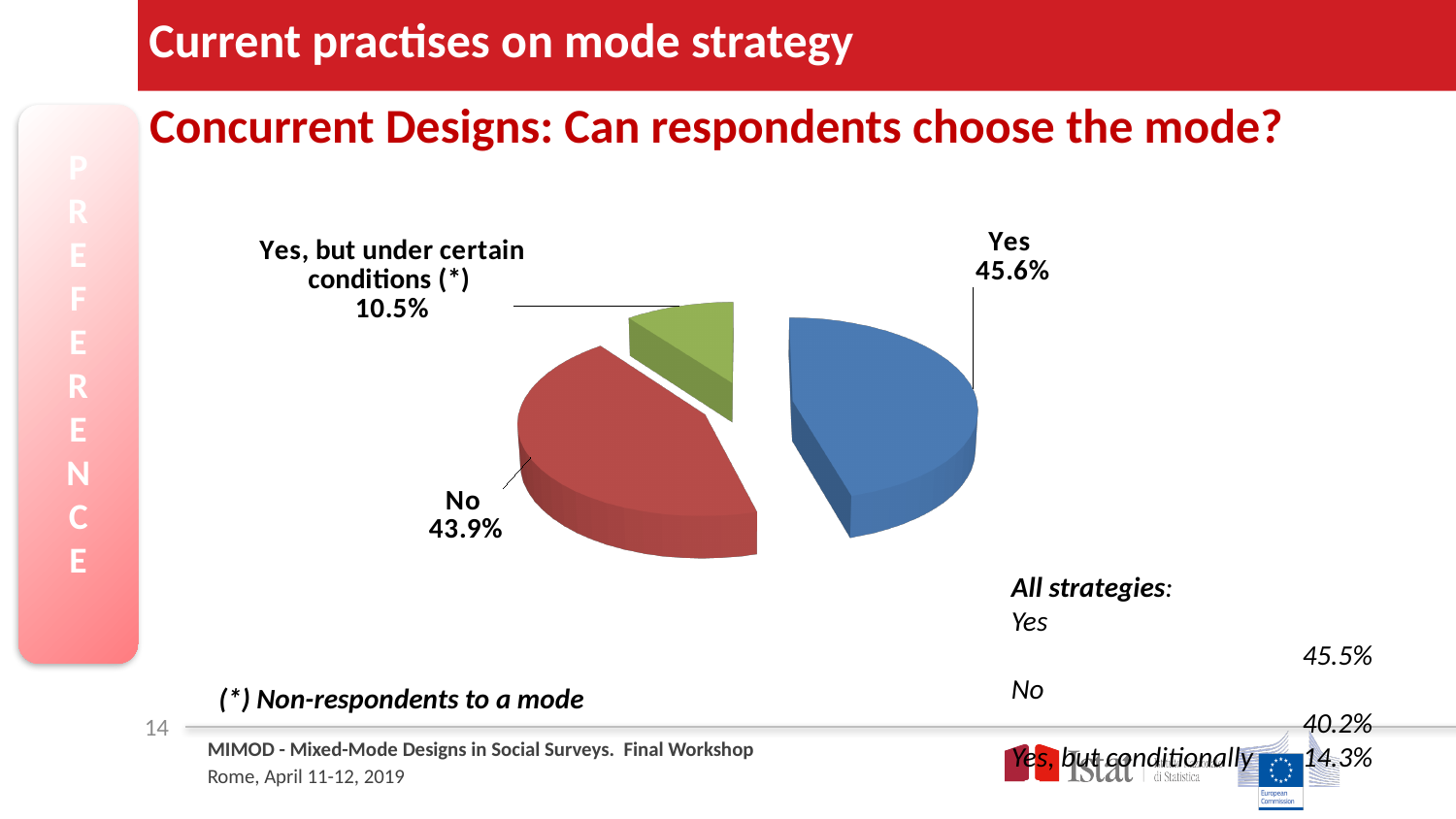
What is the difference in percentage points between the 'Yes' slice and the 'No' slice? 1.7 percentage points How many slices does the pie chart have? 3 Which category has the largest share of the pie chart? Yes What is the difference in percentage points between the 'No' slice and the 'Yes, but under certain conditions (*)' slice? 33.4 percentage points What percentage of the pie chart is the 'No' slice? 43.9% What percentage of the pie chart is the 'Yes, but under certain conditions (*)' slice? 10.5% What colour is the 'Yes' slice of the pie chart? Blue What colour is the 'No' slice of the pie chart? Red Which category has the smallest share of the pie chart? Yes, but under certain conditions (*) What type of chart is shown on the slide? Pie chart What percentage of the pie chart is the 'Yes' slice? 45.6% Which is larger: the 'No' slice or the 'Yes, but under certain conditions (*)' slice? No